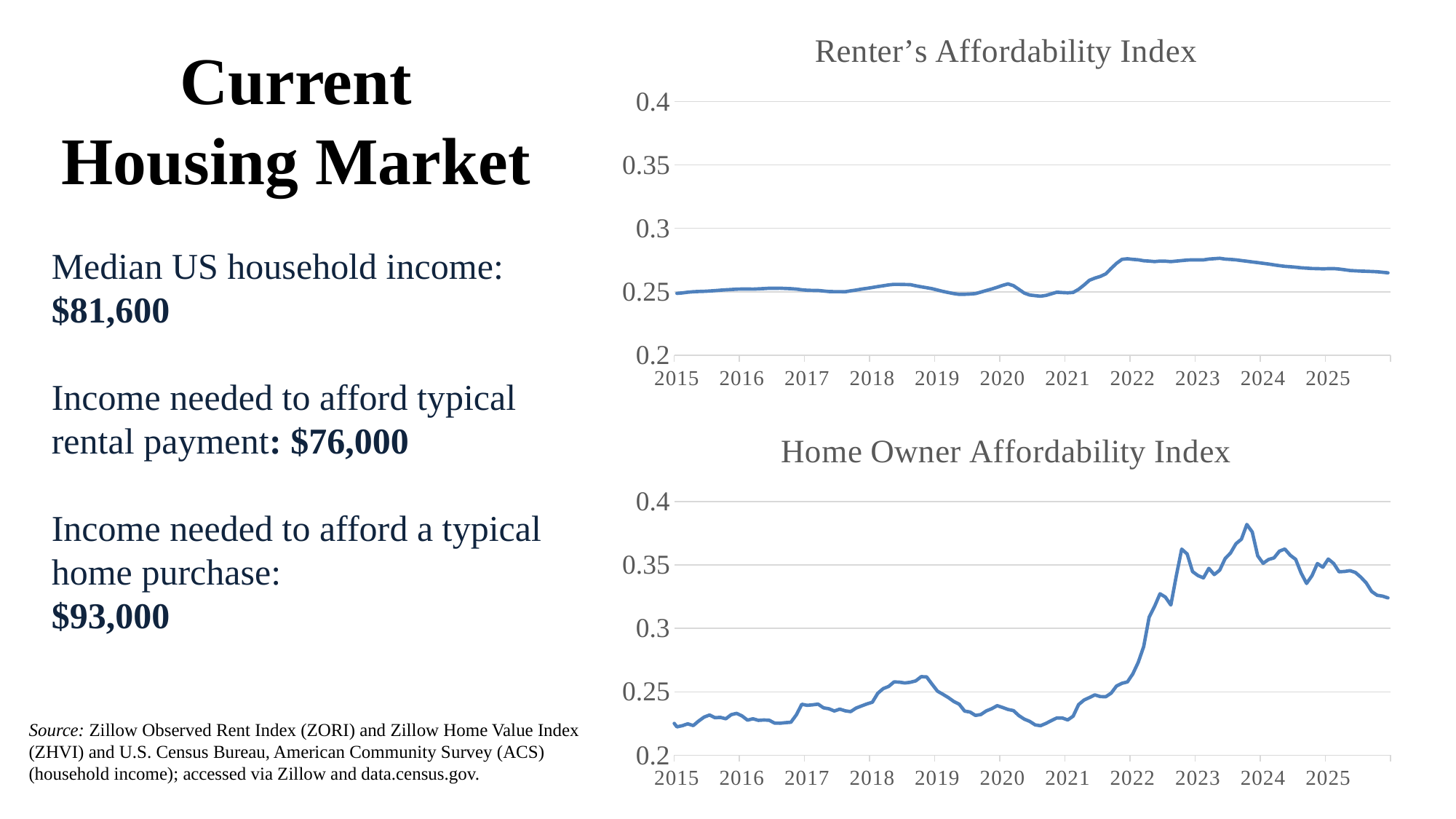
In the Renter's Affordability Index chart, is the value at the start of 2015 greater or less than 0.3? less In the Home Owner Affordability Index chart, does the line rise or fall between 2021 and 2023? rise Which chart reaches a higher peak value, the Renter's Affordability Index or the Home Owner Affordability Index? Home Owner Affordability Index In the Home Owner Affordability Index chart, is the final value at the end of the line greater or less than 0.3? greater In the Home Owner Affordability Index chart, does the line rise or fall from 2024 to the end of 2025? fall In the Home Owner Affordability Index chart, is the value at the start of 2015 greater or less than 0.25? less What kind of chart is the Home Owner Affordability Index chart? line chart How many year labels are shown on the x axis of the Home Owner Affordability Index chart? 11 What kind of chart is the Renter's Affordability Index chart? line chart In the Renter's Affordability Index chart, does the line rise or fall from 2022 to the end of 2025? fall